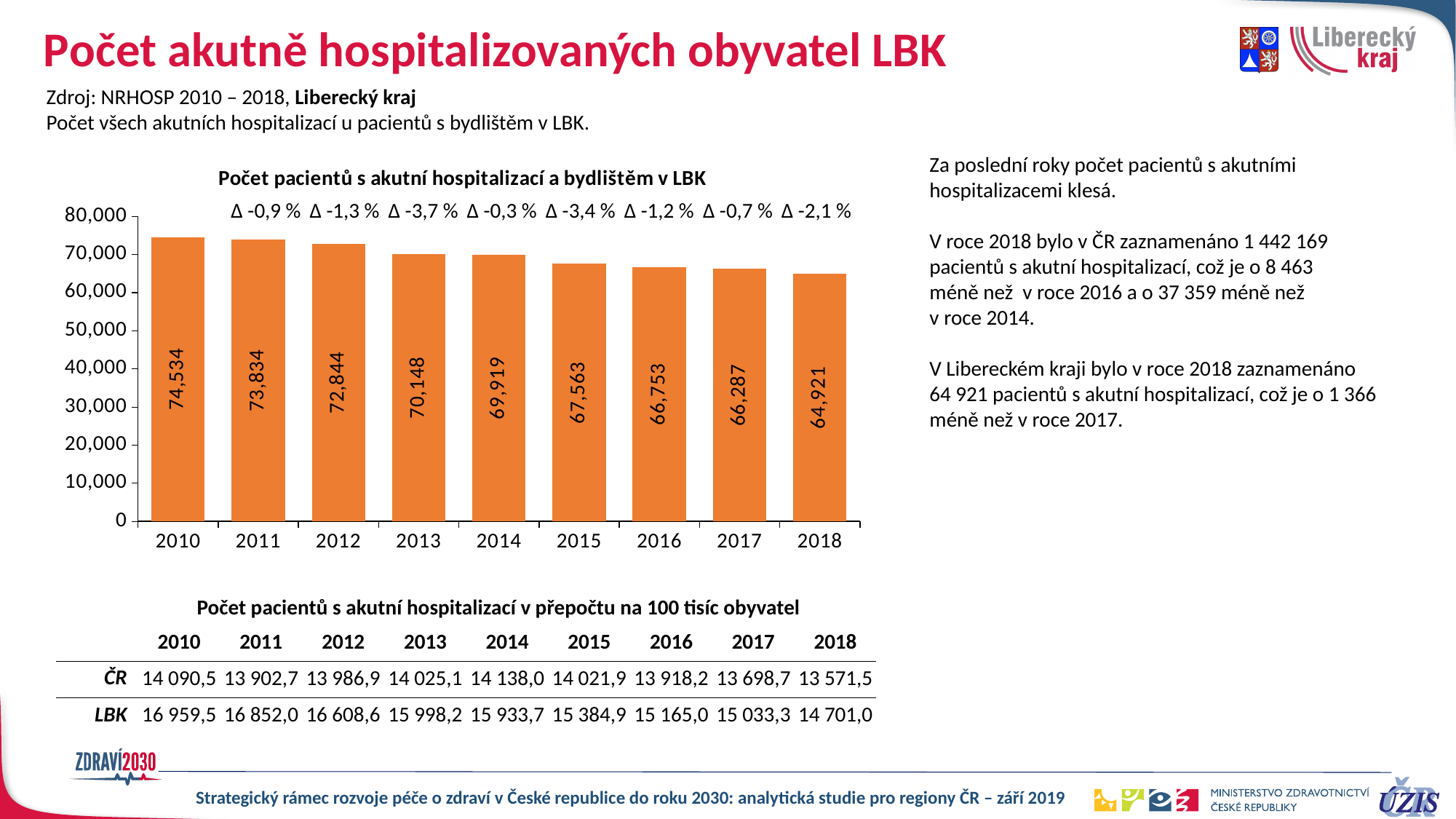
What is the value for 2018 in the chart? 64,921 Which is larger, the value for 2012 or the value for 2015? 2012 What kind of chart is shown on the slide? bar chart How many years are shown on the x axis of the chart? 9 What is the value for 2010 in the chart? 74,534 Is the value for 2013 greater or less than 70,000? greater What is the difference between the values for 2010 and 2018? 9,613 Which year has the highest value in the chart? 2010 Do the values rise or fall from 2010 to 2018? fall What is the difference between the values for 2017 and 2018? 1,366 What is the value for 2014 in the chart? 69,919 Which year has the lowest value in the chart? 2018